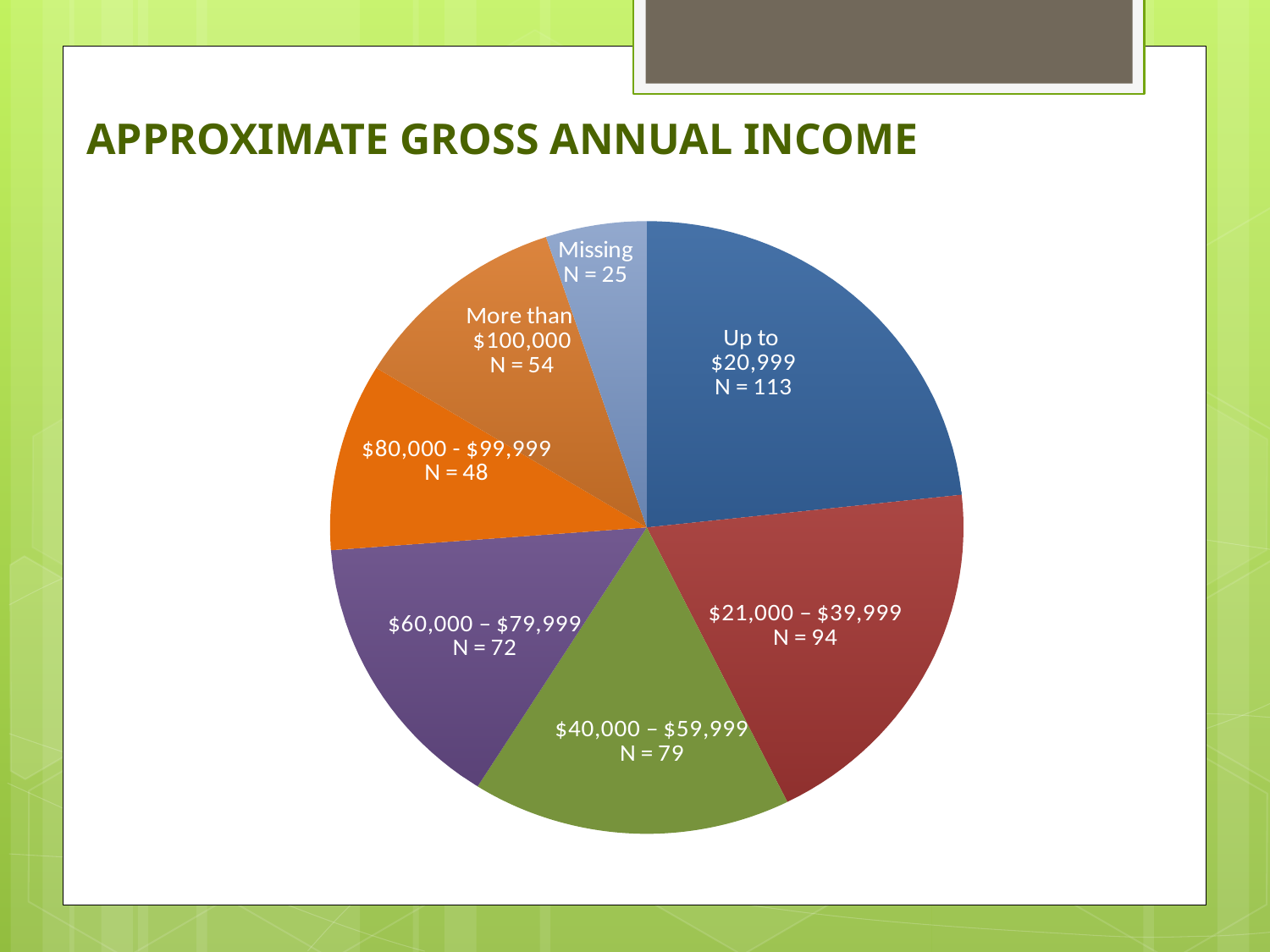
What is the N value for the '$60,000 – $79,999' slice? N = 72 Which has a larger N: '$80,000 - $99,999' or 'More than $100,000'? More than $100,000 What type of chart is shown on the slide? pie chart What is the N value for the 'Missing' slice? N = 25 What is the N value for the 'Up to $20,999' slice? N = 113 What is the total N across all slices of the pie? 485 What is the difference in N between '$21,000 – $39,999' and '$40,000 – $59,999'? 15 What is the title of the chart? APPROXIMATE GROSS ANNUAL INCOME Which slice is the smallest? Missing What colour is the 'Up to $20,999' slice? blue Which income category has the largest slice? Up to $20,999 How many slices does the pie chart have? 7